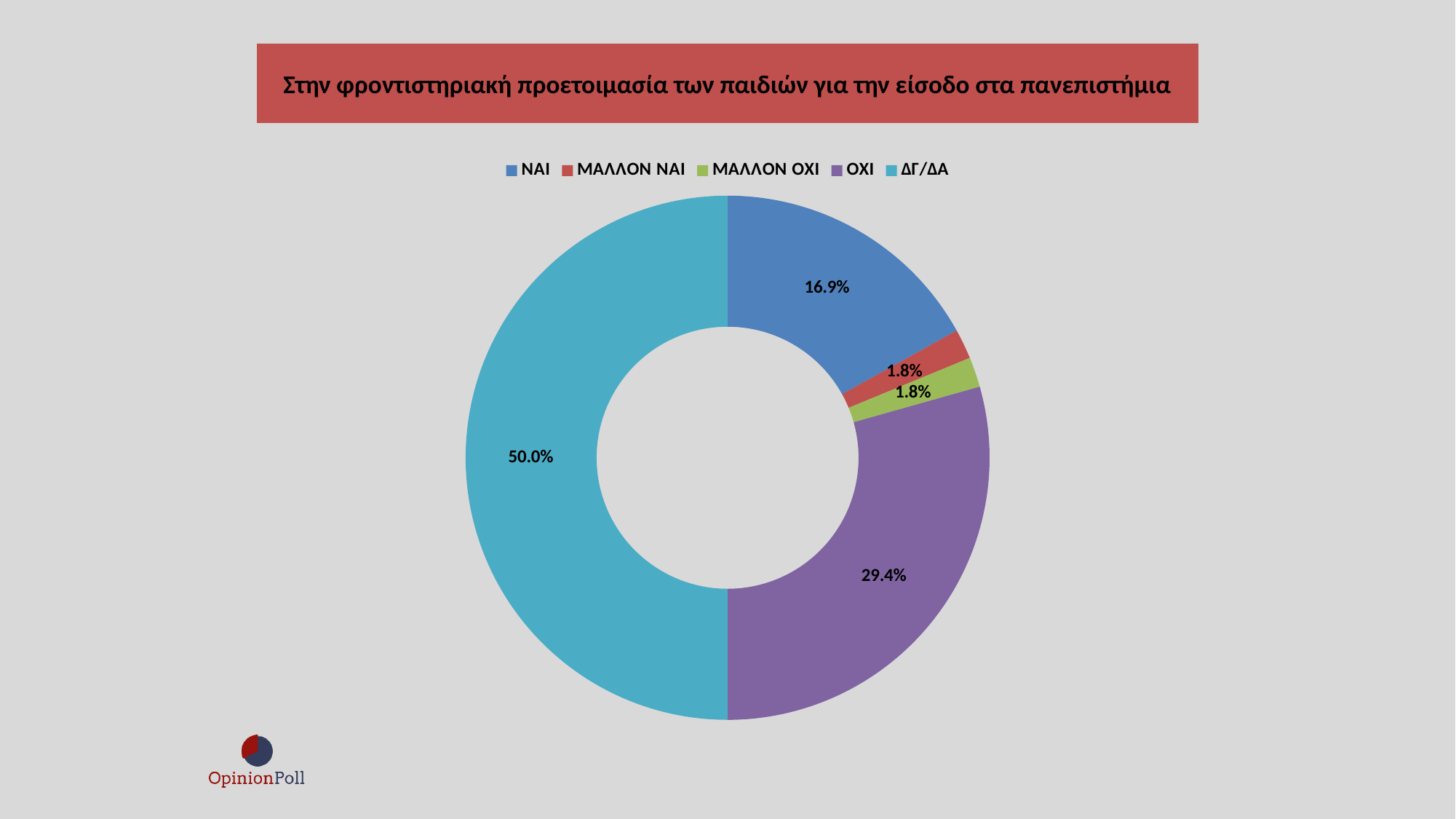
How many categories does the legend list? 5 What kind of chart is shown on the slide? Pie chart (doughnut) What is the value for ΔΓ/ΔΑ? 50.0% Which category is larger, ΝΑΙ or ΟΧΙ? ΟΧΙ What is the value for ΜΑΛΛΟΝ ΝΑΙ? 1.8% What is the difference between the values for ΔΓ/ΔΑ and ΟΧΙ? 20.6% What is the difference between the values for ΟΧΙ and ΝΑΙ? 12.5% What is the value for ΟΧΙ? 29.4% What is the value for ΝΑΙ? 16.9% Which category has the largest share? ΔΓ/ΔΑ What is the combined share of ΝΑΙ and ΜΑΛΛΟΝ ΝΑΙ? 18.7% What colour is the ΟΧΙ slice? Purple